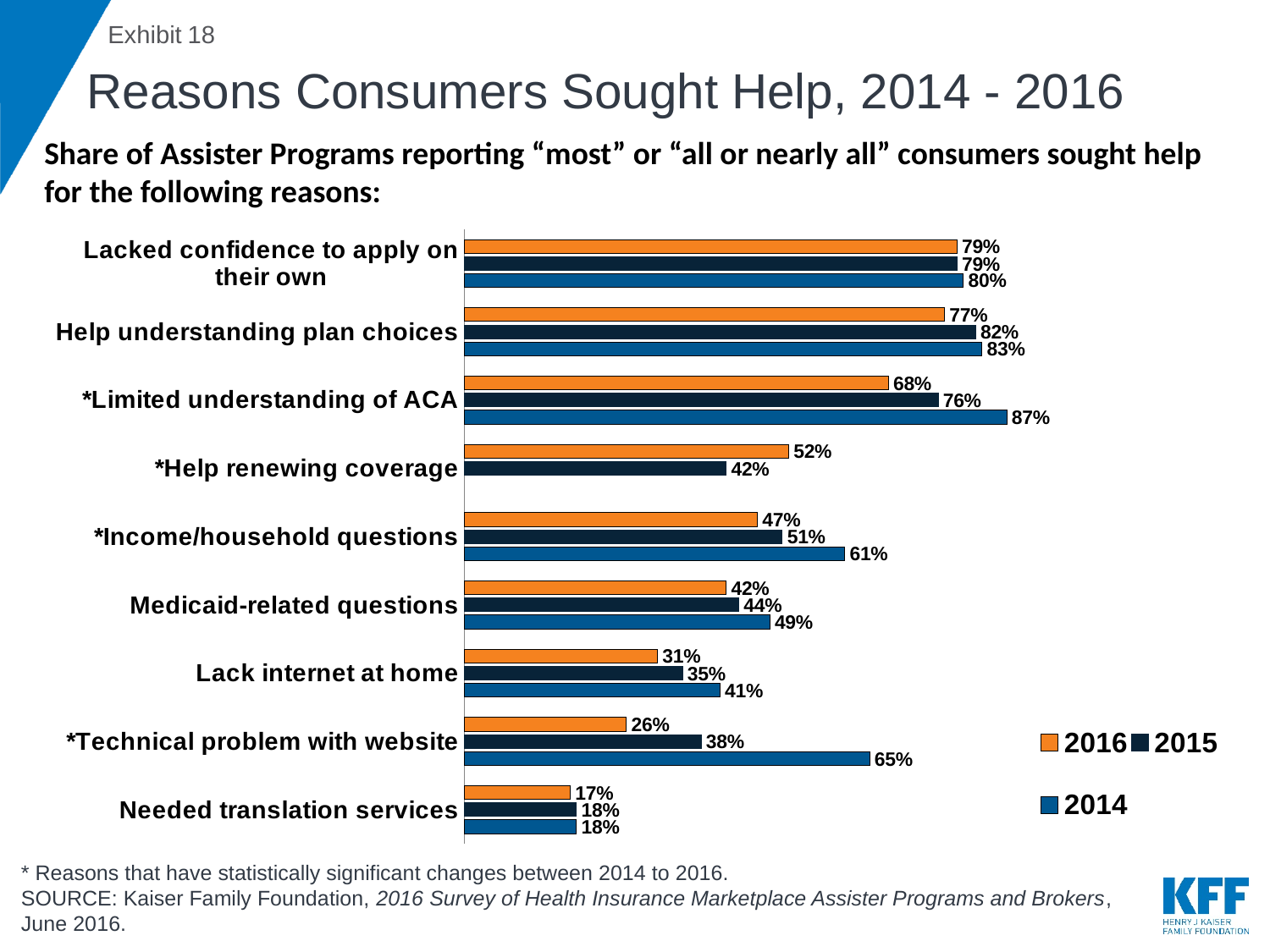
What is the difference between the 2014 and 2016 values for 'Limited understanding of ACA'? 19 percentage points How many reasons (categories) are shown on the chart? 9 Which colour represents 2016 in the legend? Orange Which reason has the lowest 2014 value? Needed translation services What kind of chart is shown on the slide? Bar chart What is the 2016 value for 'Technical problem with website'? 26% What is the 2015 value for 'Help renewing coverage'? 42% Which reason has the highest 2016 value? Lacked confidence to apply on their own What is the difference between the 2014 and 2016 values for 'Technical problem with website'? 39 percentage points Which is larger for 'Income/household questions': the 2015 value or the 2016 value? 2015 What share of assister programs reported consumers sought help for 'Limited understanding of ACA' in 2014? 87% How many series does the legend list? 3